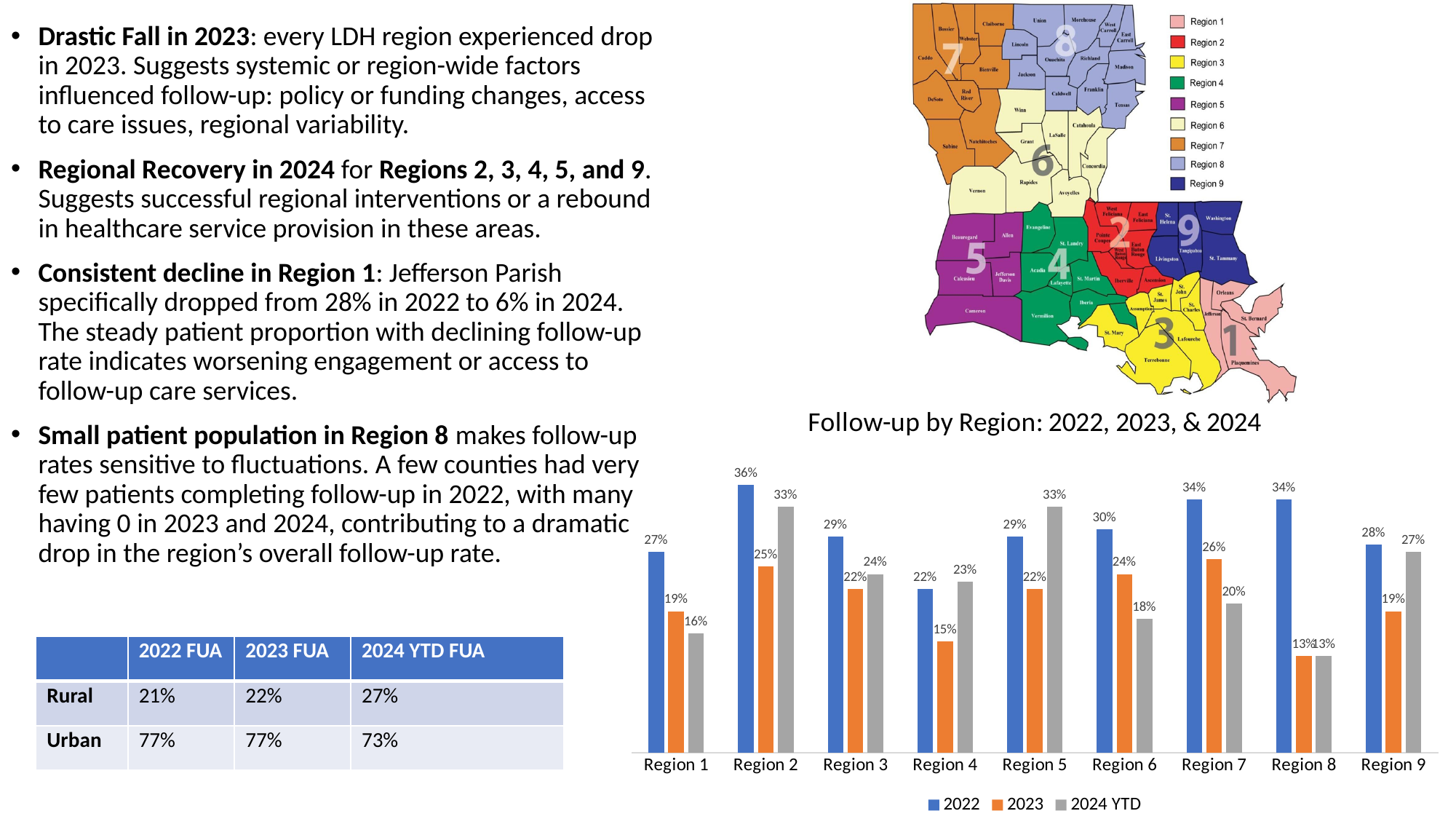
What type of chart is shown on the slide? bar chart What is the difference between the 2022 and 2024 YTD values for Region 1? 11% What is the 2024 YTD follow-up value for Region 5? 33% Do the values for Region 7 rise or fall from 2022 to 2024 YTD? fall Which is larger for Region 6: the 2023 value or the 2024 YTD value? 2023 What is the title of the chart? Follow-up by Region: 2022, 2023, & 2024 What is the 2023 follow-up value for Region 4? 15% What is the 2022 follow-up value for Region 2? 36% How many series does the legend of the chart list? 3 Which region has the highest 2022 follow-up value? Region 2 Which region has the lowest 2023 follow-up value? Region 8 How many regions are shown on the x axis of the chart? 9